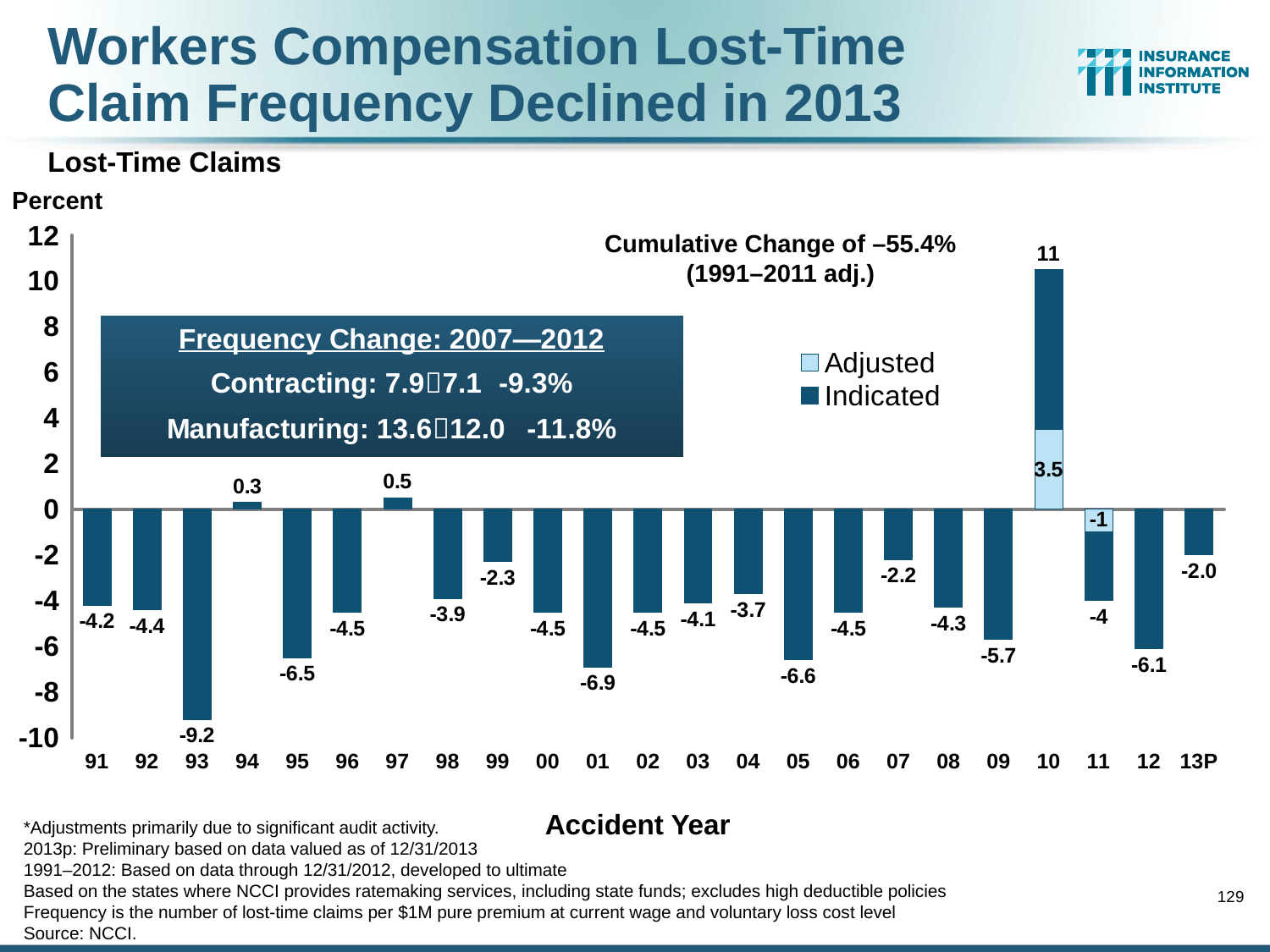
What kind of chart is shown on the slide? bar chart What cumulative change (1991–2011 adj.) is stated on the chart? –55.4% What is the value for accident year 93? -9.2 What is the Indicated value for accident year 10? 11 What is the Adjusted value for accident year 10? 3.5 Which accident year has the lowest value? 93 How many series does the legend list? 2 What is the value for accident year 97? 0.5 What is the difference between the values for accident years 12 and 13P? 4.1 What is the value for accident year 13P? -2.0 Which is larger, the value for accident year 01 or for accident year 05? 05 How many accident years are shown on the x axis? 23